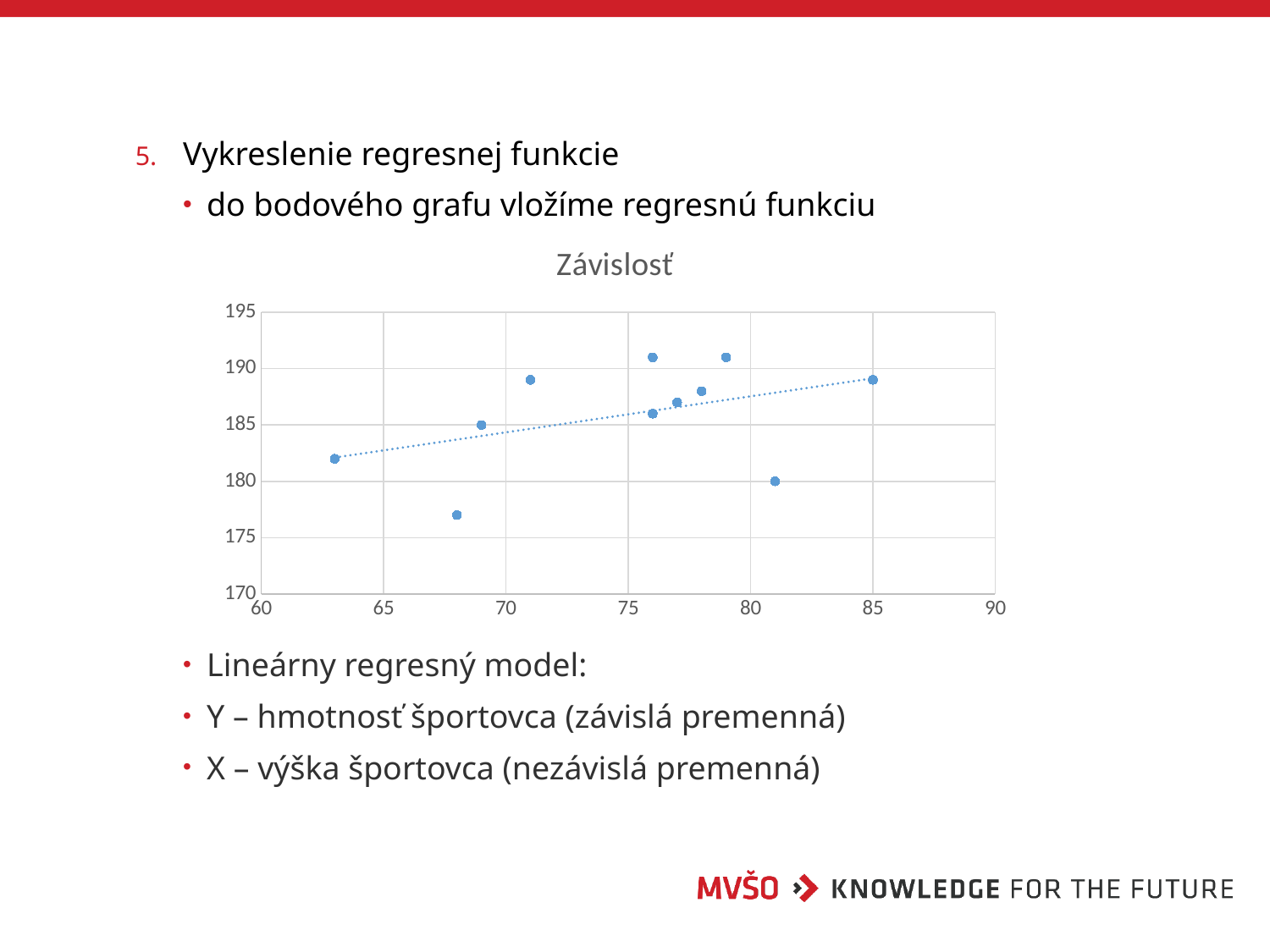
Is the value of the point at x = 68 greater or less than 180? less Is the value of the point at x = 78 greater or less than 190? less What is the maximum value shown on the y axis of the chart? 195 What is the title of the chart? Závislosť Is the value of the point at x = 81 greater or less than 185? less Which is larger, the value of the point at x = 68 or the value of the point at x = 71? the point at x = 71 Does the dotted regression line in the chart rise or fall as x increases? rise What kind of chart is shown on the slide? scatter chart